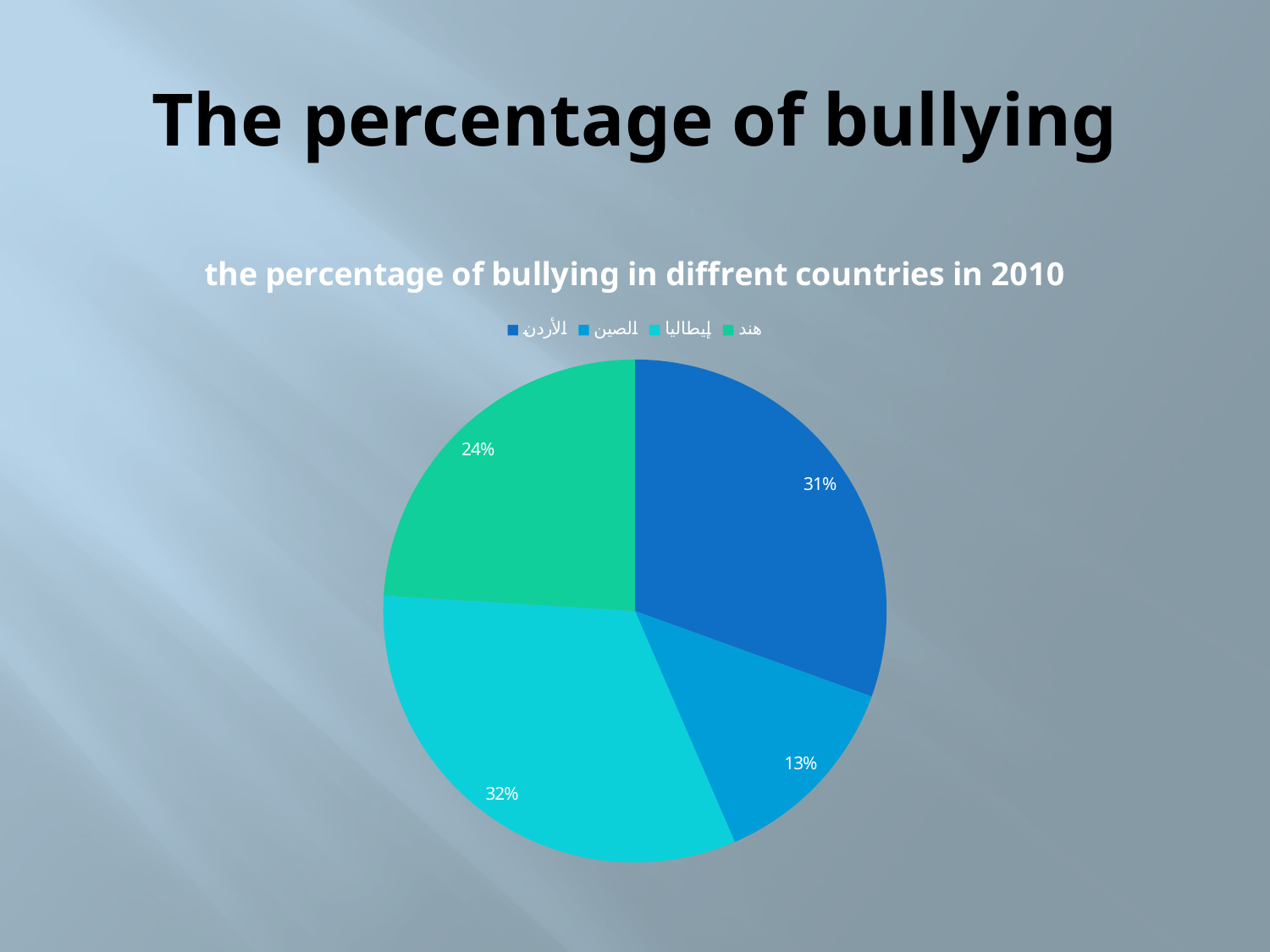
What kind of chart is shown on the slide? pie chart Which slice has the largest share of the pie? إيطاليا (32%) What is the difference between the share for الأردن and the share for الصين? 18% How many entries does the legend list? 4 What percentage is shown for the cyan slice (إيطاليا)? 32% Which is larger, the share for هند or the share for الصين? هند What percentage is shown for the medium blue slice (الصين)? 13% What is the title of the chart? the percentage of bullying in diffrent countries in 2010 How many slices does the pie chart have? 4 What percentage is shown for the green slice (هند)? 24% What percentage is shown for the dark blue slice (الأردن)? 31% Which slice has the smallest share of the pie? الصين (13%)